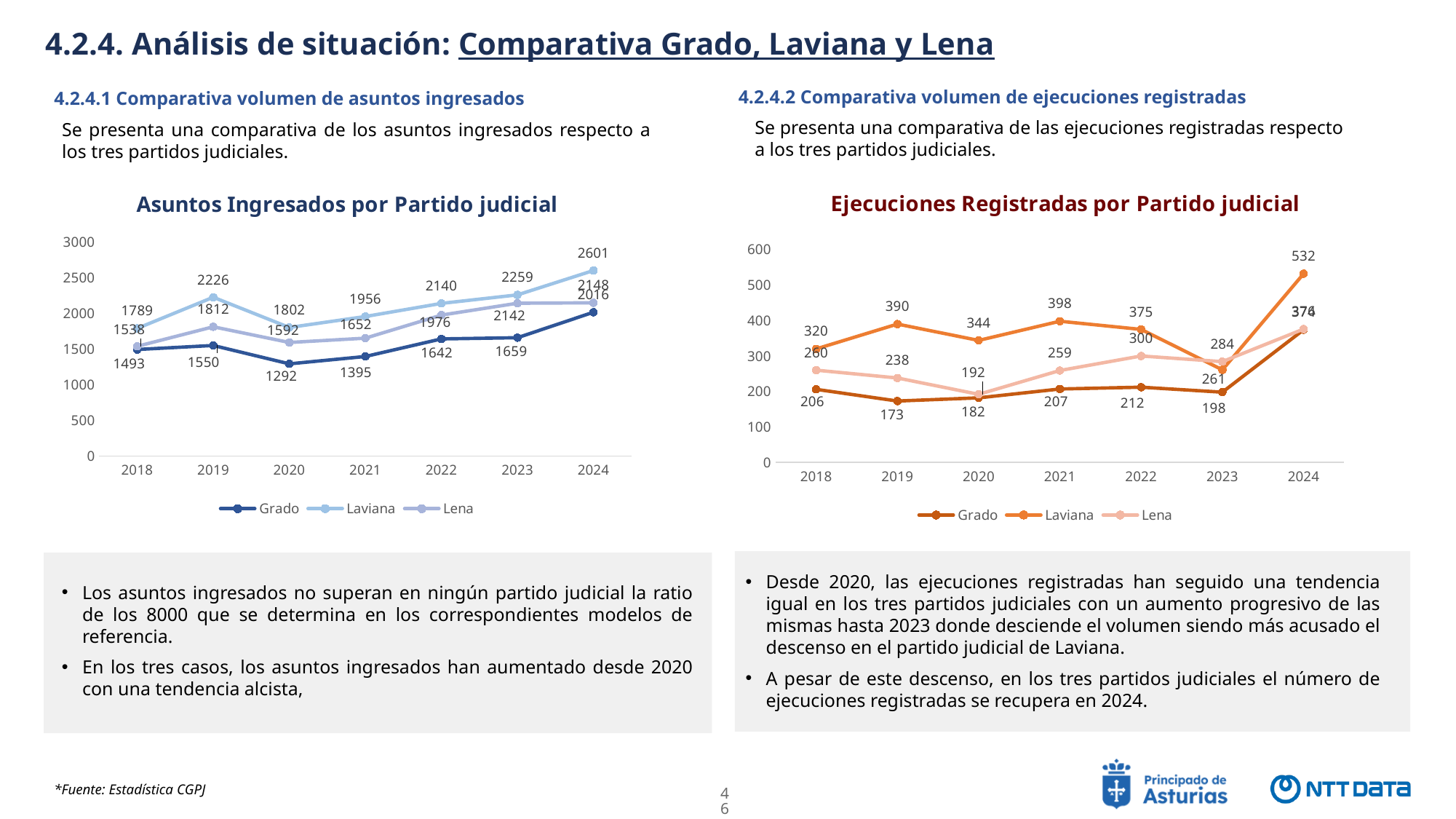
In the chart 'Ejecuciones Registradas por Partido judicial', what is the value for Laviana in 2024? 532 In the chart 'Asuntos Ingresados por Partido judicial', which is larger in 2019, Laviana or Lena? Laviana In the chart 'Asuntos Ingresados por Partido judicial', in which year does Grado have its lowest value? 2020 In the chart 'Ejecuciones Registradas por Partido judicial', what is the value for Grado in 2019? 173 In the chart 'Ejecuciones Registradas por Partido judicial', in which year does Laviana have its lowest value? 2023 In the chart 'Asuntos Ingresados por Partido judicial', what is the difference between Laviana and Grado in 2024? 585 In the chart 'Asuntos Ingresados por Partido judicial', what is the value for Grado in 2020? 1292 In the chart 'Asuntos Ingresados por Partido judicial', how many series does the legend list? 3 In the chart 'Asuntos Ingresados por Partido judicial', what is the value for Laviana in 2024? 2601 In the chart 'Ejecuciones Registradas por Partido judicial', what is the difference between Laviana's values in 2021 and 2023? 137 In the chart 'Asuntos Ingresados por Partido judicial', how many years are shown on the x axis? 7 What type of chart is 'Ejecuciones Registradas por Partido judicial'? Line chart